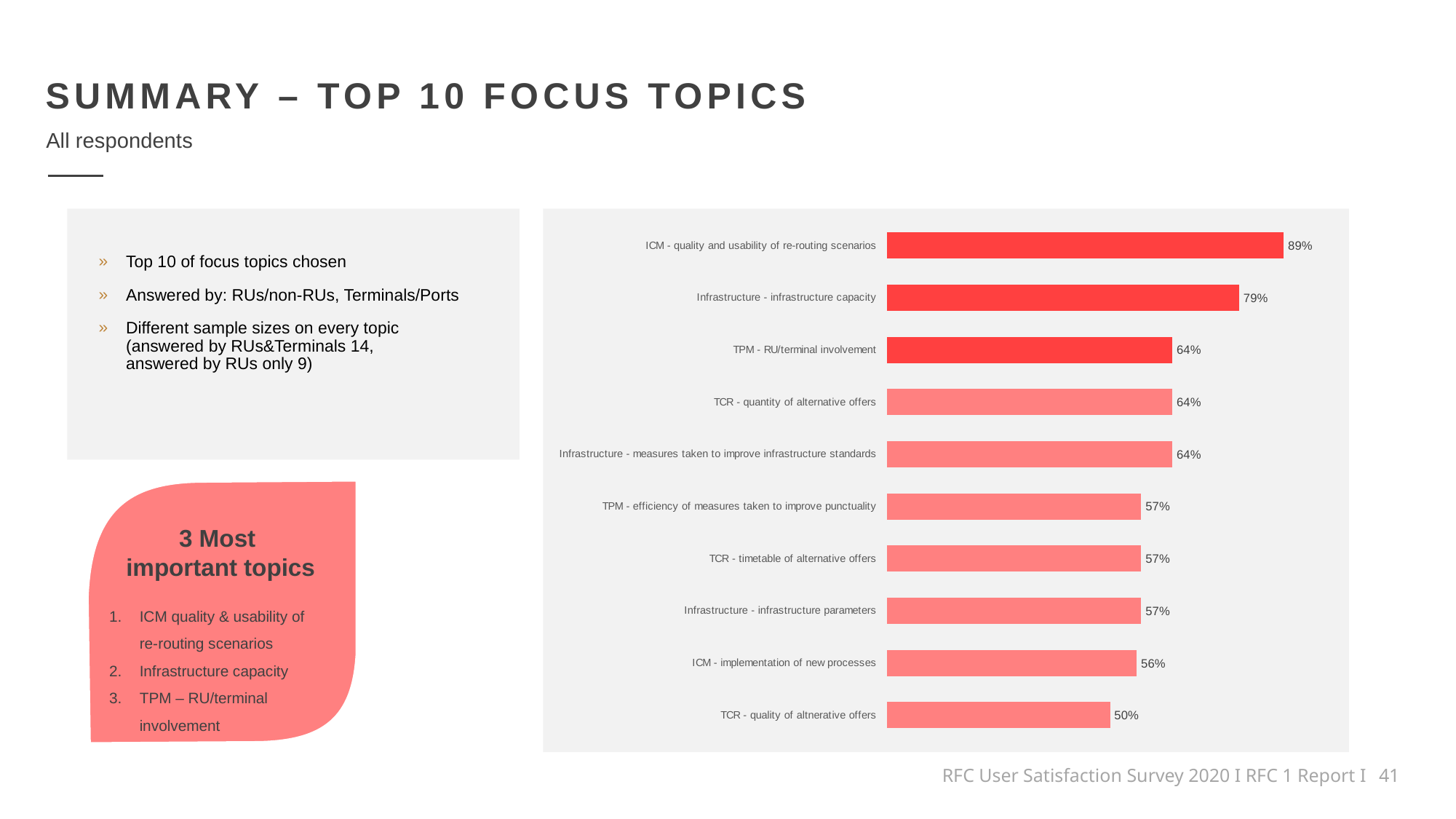
What is the difference between the values for ICM - quality and usability of re-routing scenarios and Infrastructure - infrastructure capacity? 10% What is the value for TCR - quality of altnerative offers? 50% What is the value for Infrastructure - infrastructure capacity? 79% Which category has the highest value? ICM - quality and usability of re-routing scenarios What kind of chart is shown on the slide? Bar chart How many bars are drawn in the darker red colour? 3 How many categories are shown in the chart? 10 Which is larger: the value for TPM - RU/terminal involvement or the value for TPM - efficiency of measures taken to improve punctuality? TPM - RU/terminal involvement What is the value for ICM - implementation of new processes? 56% Which category has the lowest value? TCR - quality of altnerative offers What is the value for ICM - quality and usability of re-routing scenarios? 89% How many categories share the value 57%? 3